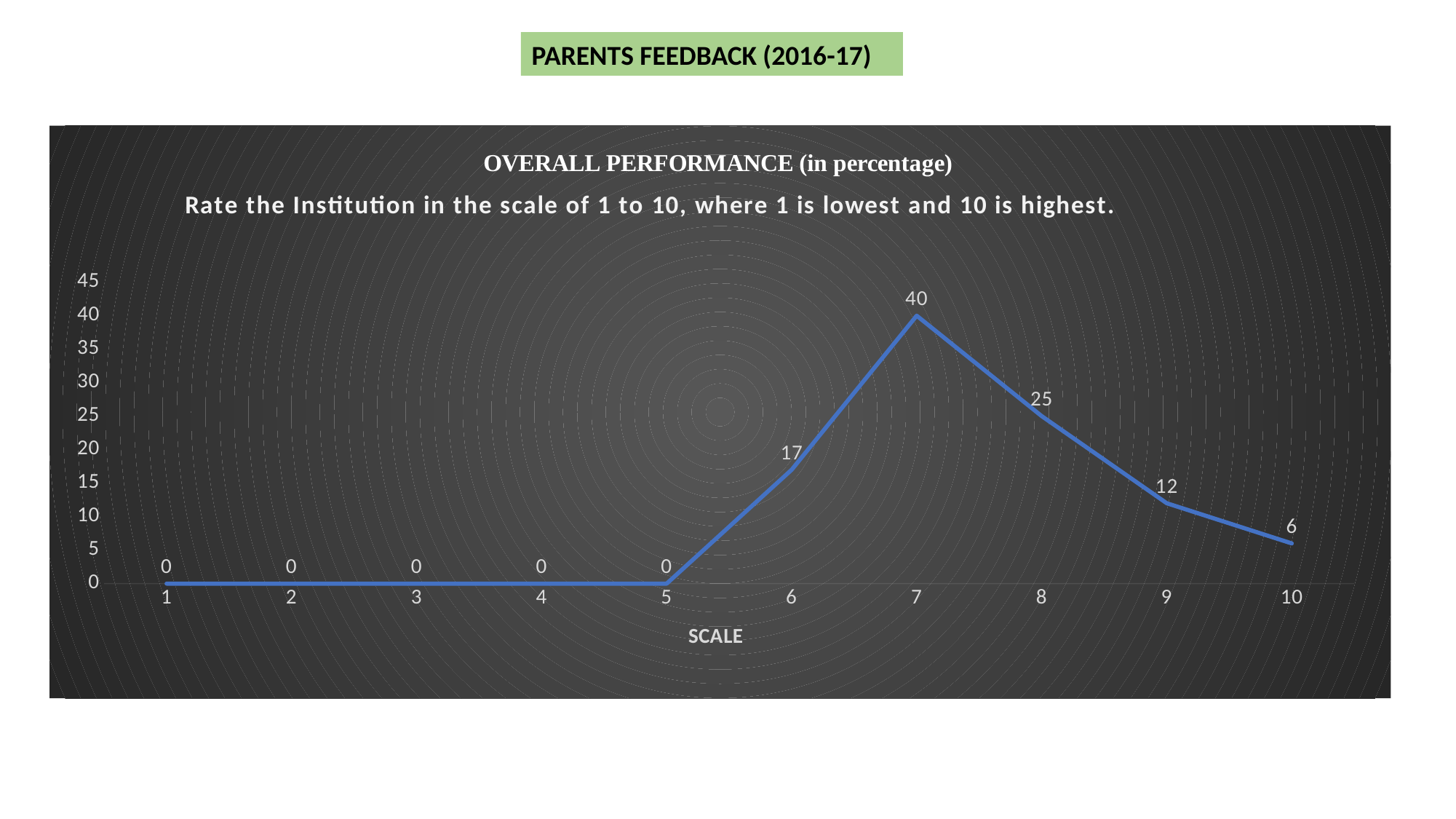
What kind of chart is shown? line chart What is the x-axis title of the chart? SCALE What is the difference between the values at scale points 7 and 8? 15 What is the value at scale point 9? 12 What is the value at scale point 6? 17 What is the value at scale point 7? 40 Do the values rise or fall from scale point 7 to scale point 10? fall Which is larger, the value at scale point 6 or at scale point 8? 8 What is the value at scale point 10? 6 How many scale points are plotted on the x axis? 10 Which scale point has the highest value? 7 What is the difference between the values at scale points 8 and 9? 13